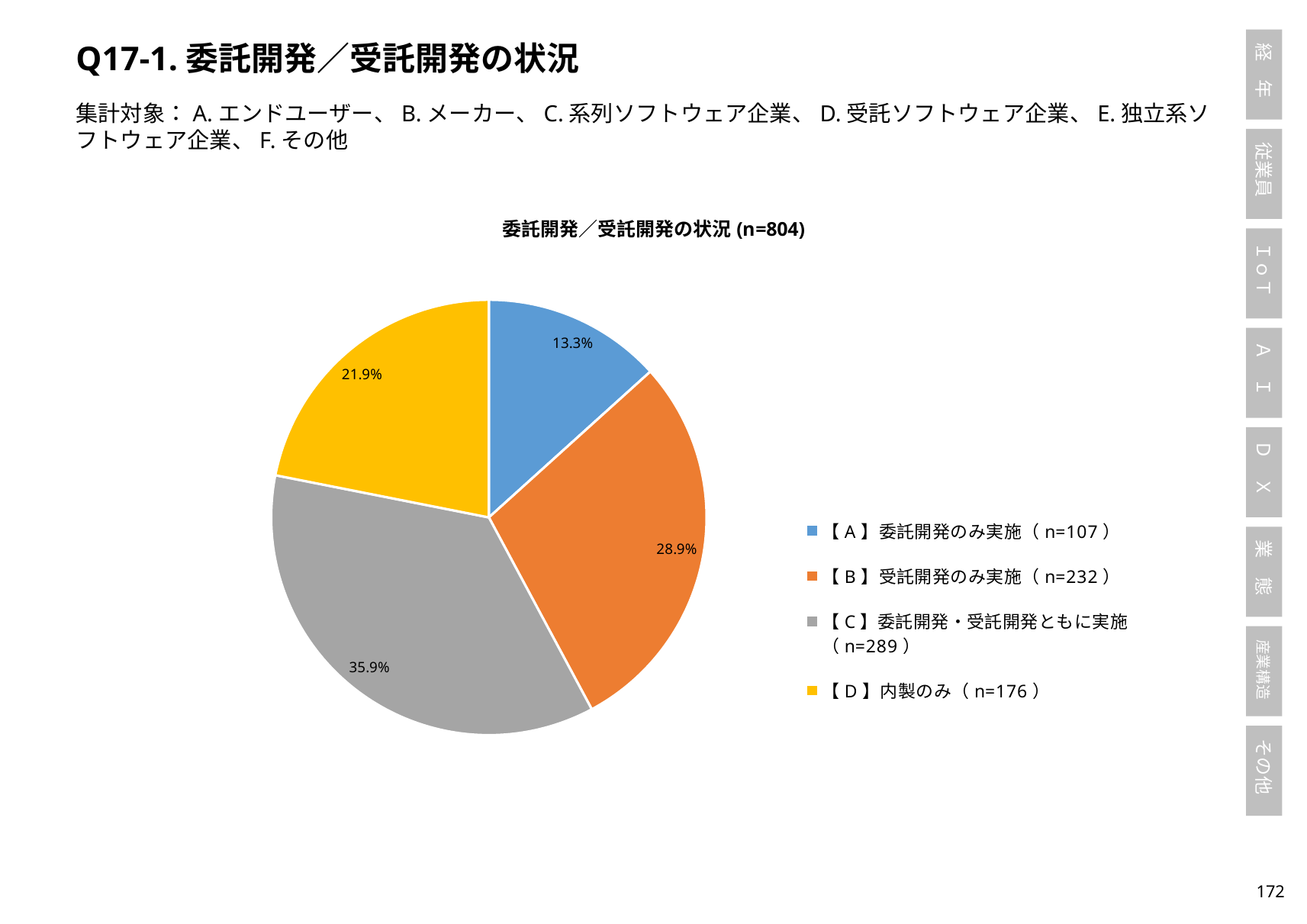
What is the total number of respondents (n) shown in the chart title? 804 What share of the pie does 【D】内製のみ represent? 21.9% How many categories does the pie chart have? 4 What share of the pie does 【A】委託開発のみ実施 represent? 13.3% Which category has the smallest slice of the pie? 【A】委託開発のみ実施 What share of the pie does 【C】委託開発・受託開発ともに実施 represent? 35.9% What colour is the slice for 【C】委託開発・受託開発ともに実施? gray Which is larger, the share for 【D】内製のみ or the share for 【A】委託開発のみ実施? 【D】内製のみ What is the difference in percentage points between 【C】委託開発・受託開発ともに実施 and 【B】受託開発のみ実施? 7.0 percentage points Which category has the largest slice of the pie? 【C】委託開発・受託開発ともに実施 What type of chart is shown on the slide? pie chart